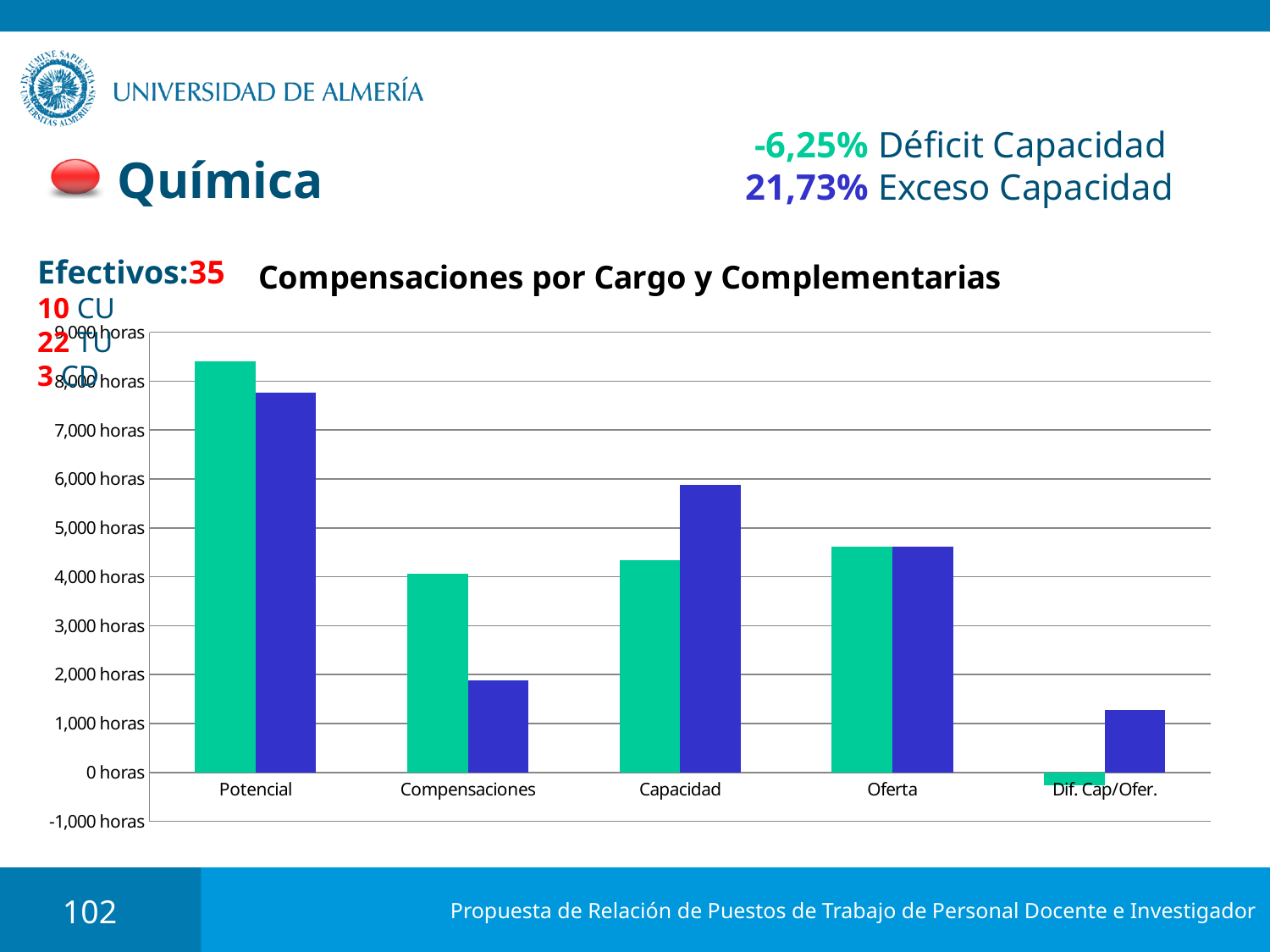
Is the green bar for Oferta greater or less than 5,000 horas? less Is the blue bar for Capacidad greater or less than 5,000 horas? greater What kind of chart is shown on the slide? bar chart For Capacidad, which bar is larger, the green one or the blue one? the blue one Is the blue bar for Compensaciones greater or less than 2,000 horas? less What is the title of the chart? Compensaciones por Cargo y Complementarias How many categories are shown on the x axis of the chart? 5 For Compensaciones, which bar is larger, the green one or the blue one? the green one Which category has the highest green bar? Potencial